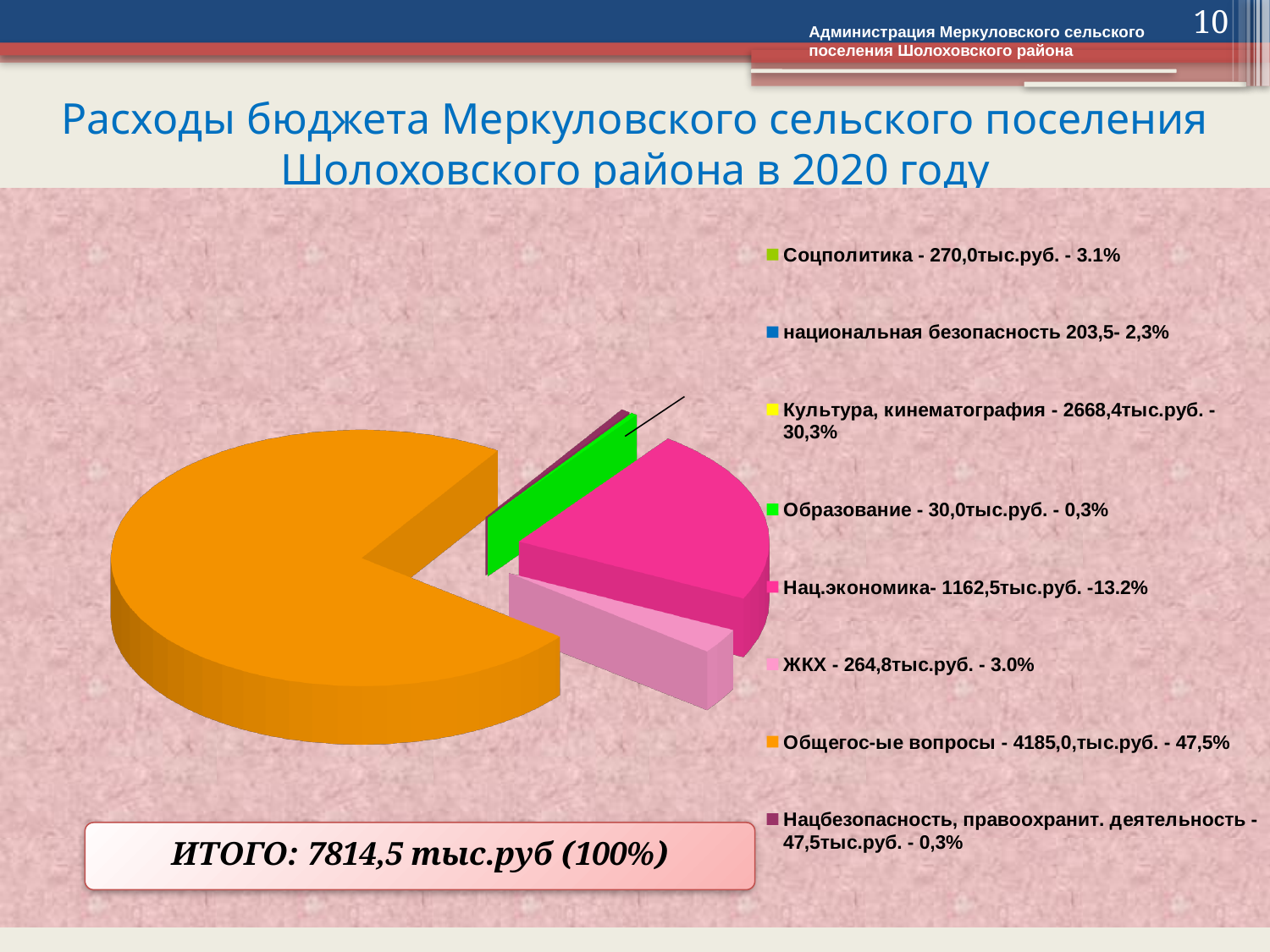
What is the value for Нац.экономика? 1162,5 тыс.руб. What is the difference between the values for Общегос-ые вопросы and Культура, кинематография? 1516,6 тыс.руб. What is the value for Культура, кинематография? 2668,4 тыс.руб. What kind of chart is shown on the slide? Pie chart Which category has the largest share of the pie? Общегос-ые вопросы What share of the pie does Культура, кинематография represent? 30,3% What total amount is shown in the ИТОГО box below the chart? 7814,5 тыс.руб (100%) How many categories does the legend of the pie chart list? 8 Which category has the lowest value in тыс.руб.? Образование What is the value for национальная безопасность? 203,5 Which is larger, the value for Соцполитика or the value for ЖКХ? Соцполитика What is the value for Общегос-ые вопросы? 4185,0 тыс.руб.